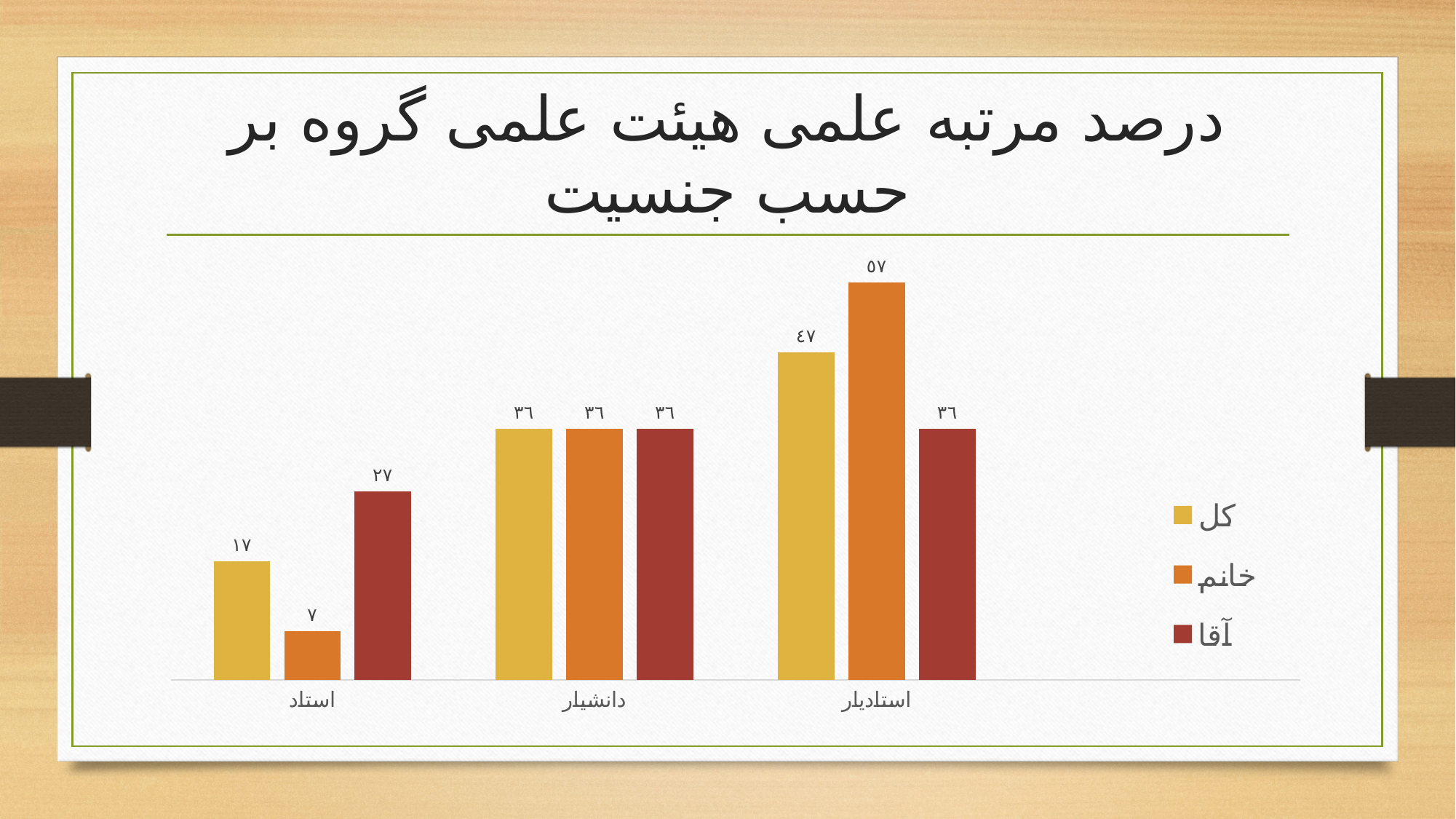
How many series does the legend list? 3 What is the value for خانم in the استاد category? ٧ What is the value for کل in the استادیار category? ٤٧ What kind of chart is shown on the slide? bar chart Which category has the lowest value for the کل series? استاد What is the value for خانم in the استادیار category? ٥٧ Which category has the highest value for the خانم series? استادیار Which series is shown in dark red in the legend? آقا What is the difference between the خانم and کل values in the استادیار category? ١٠ Which is larger in the استاد category: the value for کل or the value for آقا? آقا How many categories are shown on the x axis? 3 What is the value for آقا in the استاد category? ٢٧